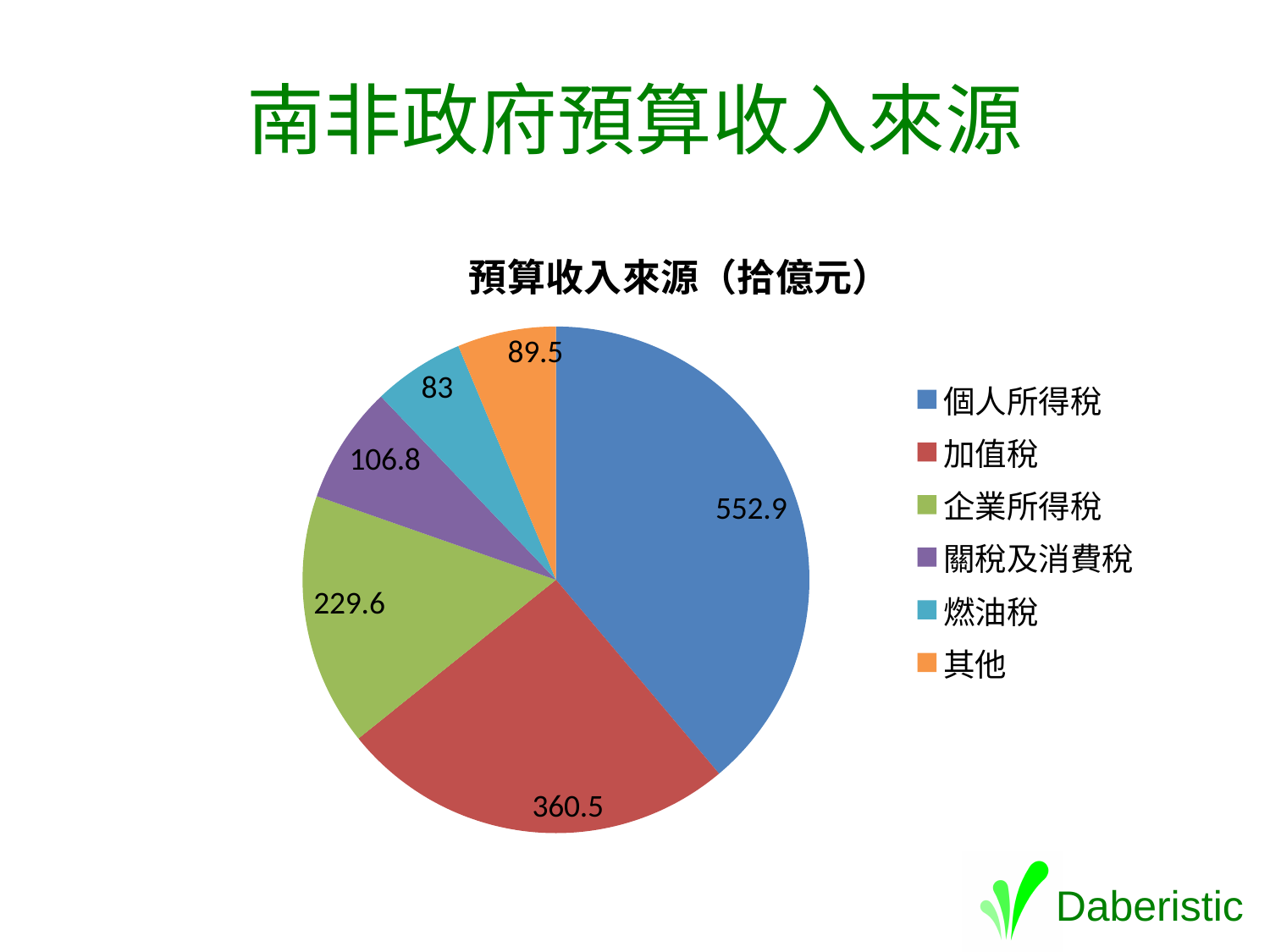
What is the value for 燃油稅 in the pie chart? 83 What kind of chart is shown on the slide? Pie chart What is the title of the chart? 預算收入來源（拾億元） Which is larger, the value for 企業所得稅 or the value for 關稅及消費稅? 企業所得稅 What is the value for 個人所得稅 in the pie chart? 552.9 What is the value for 關稅及消費稅 in the pie chart? 106.8 What is the difference between the values for 其他 and 燃油稅? 6.5 Which category has the largest slice in the pie chart? 個人所得稅 What is the difference between the values for 個人所得稅 and 加值稅? 192.4 How many categories are shown in the pie chart? 6 Which category has the smallest slice in the pie chart? 燃油稅 What is the value for 加值稅 in the pie chart? 360.5